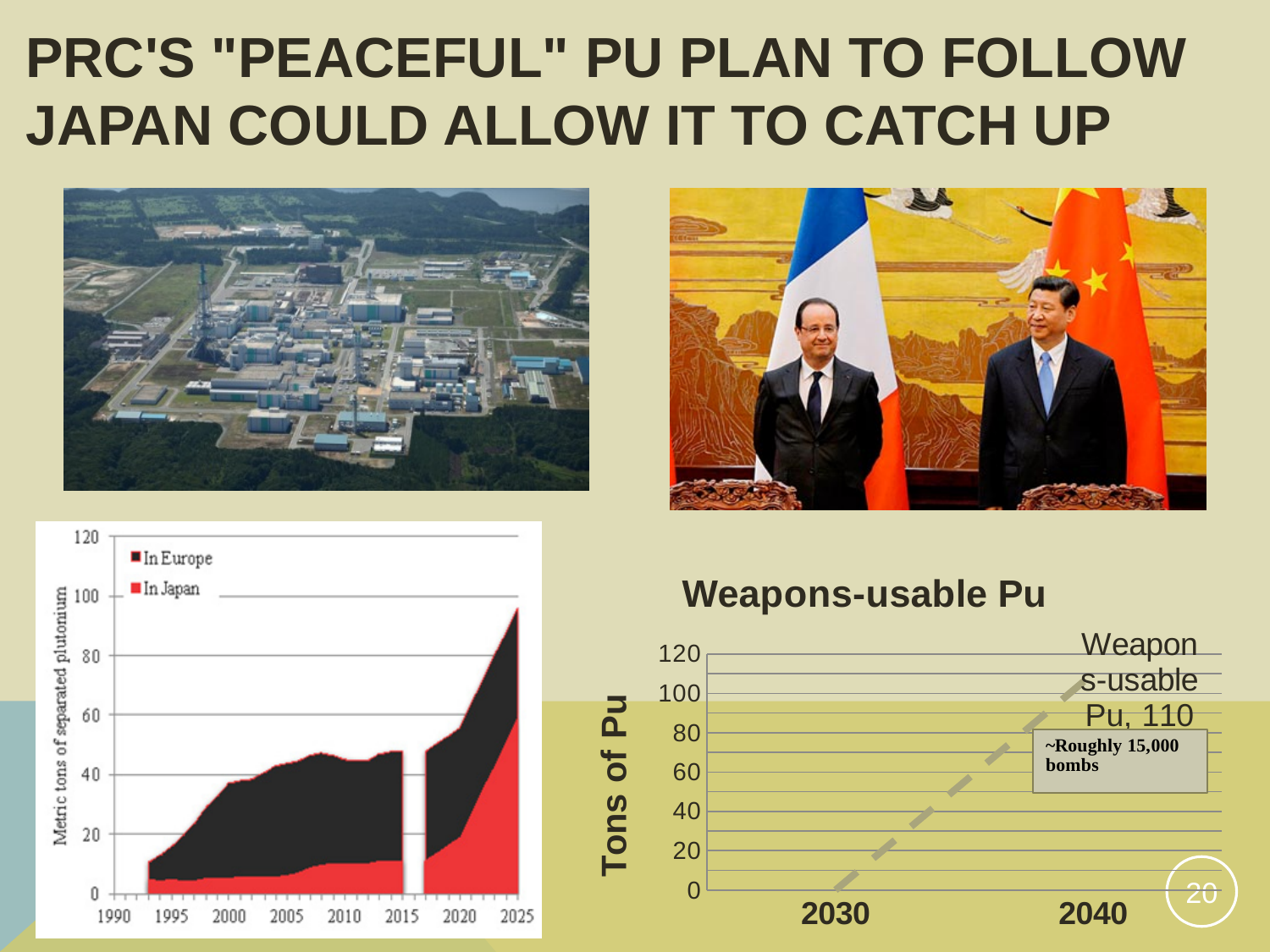
In the chart on the bottom left, is the value for 'In Japan' in 2010 greater or less than 20? less In the chart on the bottom left, does the total separated plutonium generally rise or fall from 1995 to 2025? rise What kind of chart is the 'Weapons-usable Pu' chart? line chart In the chart on the bottom left, what is the y-axis label? Metric tons of separated plutonium In the 'Weapons-usable Pu' chart, what is the y-axis title? Tons of Pu In the chart on the bottom left, is the total separated plutonium in 2025 greater or less than 80? greater In the chart on the bottom left, how many series does the legend list? 2 In the 'Weapons-usable Pu' chart, how many years are labelled on the x axis? 2 In the 'Weapons-usable Pu' chart, what does the annotation box say the plutonium amount is roughly equivalent to? ~Roughly 15,000 bombs In the 'Weapons-usable Pu' chart, what value is labelled for 2040? 110 In the 'Weapons-usable Pu' chart, is the value for 2040 greater or less than 100? greater In the 'Weapons-usable Pu' chart, does the line rise or fall from 2030 to 2040? rise